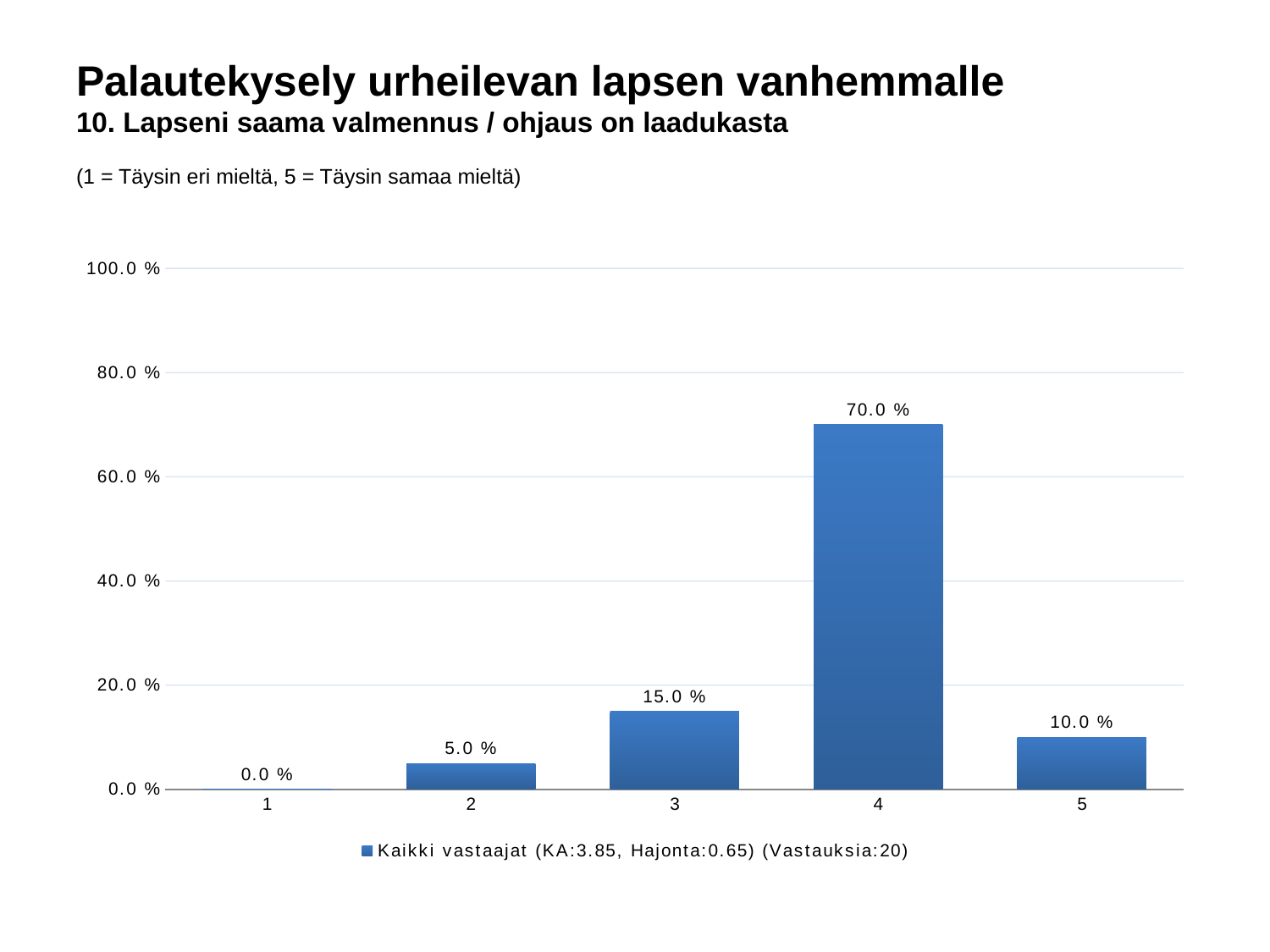
Which category has the lowest value? 1 What kind of chart is shown on the slide? bar chart What is the value for category 5? 10.0 % What is the value for category 1? 0.0 % What is the value for category 2? 5.0 % Which is larger, the value for category 3 or the value for category 5? 3 How many categories are shown on the x axis? 5 Which category has the highest value? 4 Is the value for category 4 greater or less than 60.0 %? greater What is the value for category 4? 70.0 % What is the difference between the values for category 4 and category 3? 55.0 % How many responses (Vastauksia) does the legend report? 20